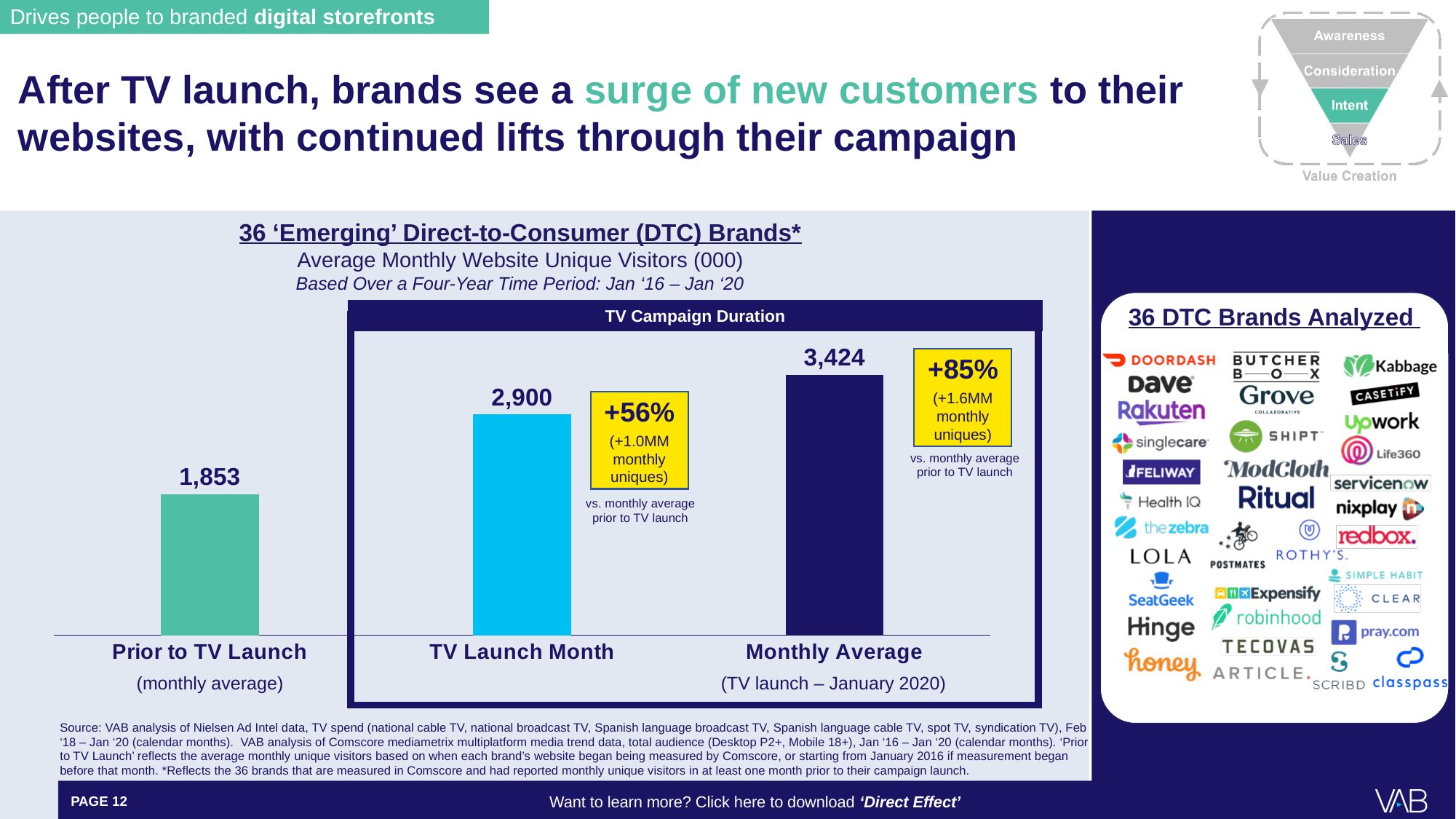
Which category has the lowest value in the chart? Prior to TV Launch What is the average monthly website unique visitors (000) value for Prior to TV Launch? 1,853 What is the value shown for TV Launch Month? 2,900 What percentage lift vs. the monthly average prior to TV launch is shown in the callout for the Monthly Average bar? +85% How many bars are plotted in the chart? 3 Which is larger, the value for TV Launch Month or the value for Prior to TV Launch? TV Launch Month What kind of chart is shown on the slide? Bar chart Do the values rise or fall from left to right across the chart? Rise What is the value shown for Monthly Average (TV launch – January 2020)? 3,424 Which category has the highest value in the chart? Monthly Average (TV launch – January 2020) What is the difference between the Monthly Average value and the TV Launch Month value? 524 What is the difference between the TV Launch Month value and the Prior to TV Launch value? 1,047